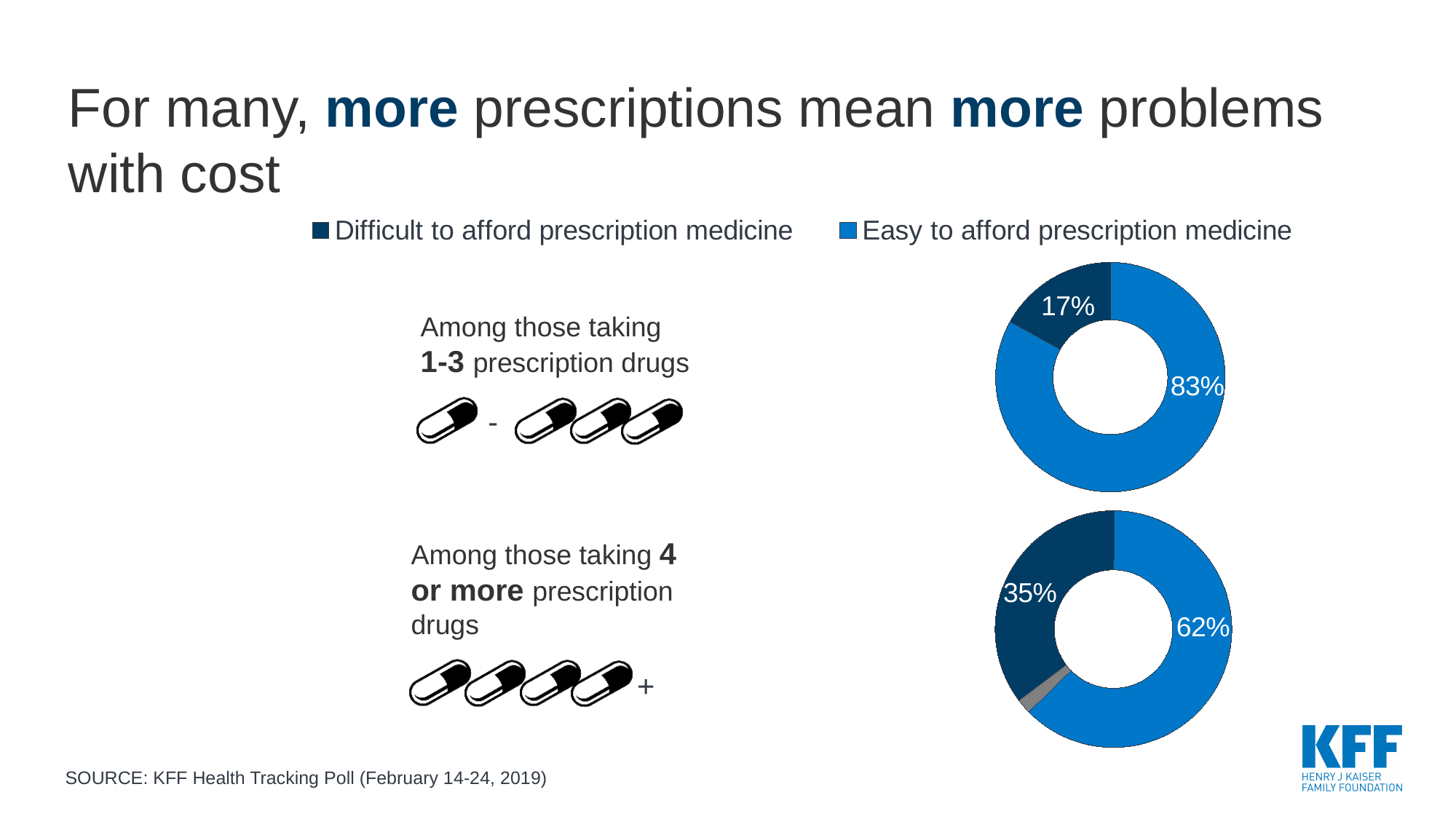
What is the difference between the 'Difficult to afford' share for those taking 4 or more prescription drugs and the 'Difficult to afford' share for those taking 1-3 prescription drugs? 18 percentage points In the donut chart for those taking 4 or more prescription drugs, what percentage find it difficult to afford prescription medicine? 35% In the bottom donut chart (4 or more prescription drugs), which is larger: the share finding it difficult or the share finding it easy to afford prescription medicine? Easy to afford prescription medicine In the donut chart for those taking 1-3 prescription drugs, what percentage find it difficult to afford prescription medicine? 17% Which colour represents 'Difficult to afford prescription medicine' in the legend? Dark blue What kind of chart is used to show the shares for each prescription group on this slide? Donut (pie) chart In the top donut chart (1-3 prescription drugs), what is the difference between the 'Easy to afford' and 'Difficult to afford' shares? 66 percentage points How many series does the legend list? 2 In the top donut chart (1-3 prescription drugs), which is larger: the share finding it difficult or the share finding it easy to afford prescription medicine? Easy to afford prescription medicine In the donut chart for those taking 1-3 prescription drugs, what percentage find it easy to afford prescription medicine? 83% Which prescription group has the higher share finding it difficult to afford prescription medicine? Those taking 4 or more prescription drugs In the donut chart for those taking 4 or more prescription drugs, what percentage find it easy to afford prescription medicine? 62%